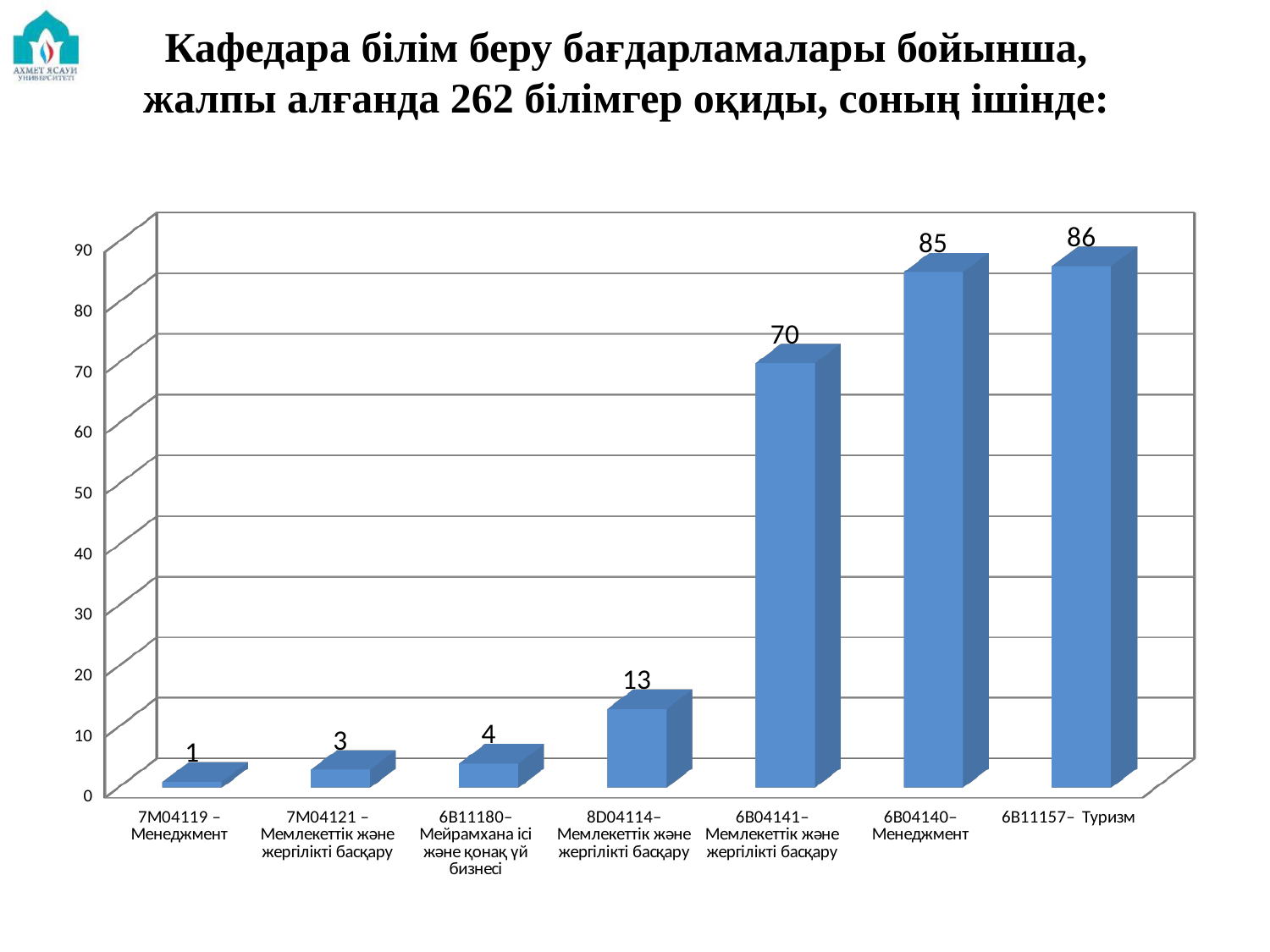
What kind of chart is shown on the slide? bar chart What is the value for 6B11157– Туризм? 86 How many categories are shown in the chart? 7 What is the highest value shown on the vertical axis? 90 What is the value for 6B04141– Мемлекеттік және жергілікті басқару? 70 Which category has the highest value? 6B11157– Туризм Which is larger, the value for 6B11180– Мейрамхана ісі және қонақ үй бизнесі or the value for 8D04114– Мемлекеттік және жергілікті басқару? 8D04114– Мемлекеттік және жергілікті басқару What is the value for 7M04121 – Мемлекеттік және жергілікті басқару? 3 Is the value for 6B04141– Мемлекеттік және жергілікті басқару greater or less than 60? greater Which category has the lowest value? 7M04119 – Менеджмент What is the value for 8D04114– Мемлекеттік және жергілікті басқару? 13 What is the difference between the values for 6B04140– Менеджмент and 6B04141– Мемлекеттік және жергілікті басқару? 15